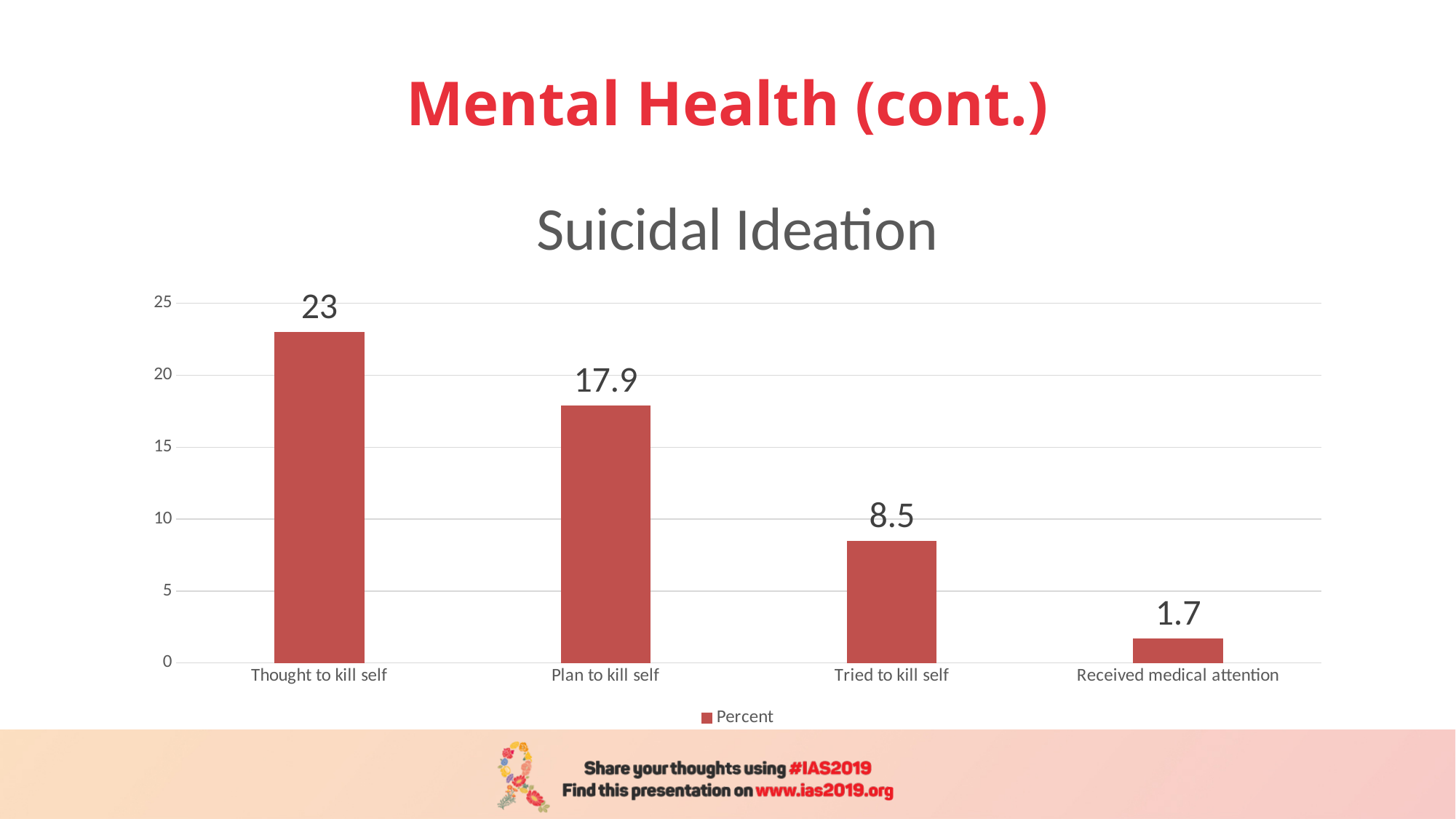
Which category has the lowest value? Received medical attention Which is larger, the value for "Tried to kill self" or "Received medical attention"? Tried to kill self What kind of chart is shown? Bar chart What is the value for "Plan to kill self"? 17.9 How many series does the legend list? 1 What is the difference between the values for "Thought to kill self" and "Plan to kill self"? 5.1 How many categories are shown on the chart? 4 What is the value for "Tried to kill self"? 8.5 What is the value for "Thought to kill self"? 23 What is the title of the chart? Suicidal Ideation What is the value for "Received medical attention"? 1.7 Which category has the highest value? Thought to kill self